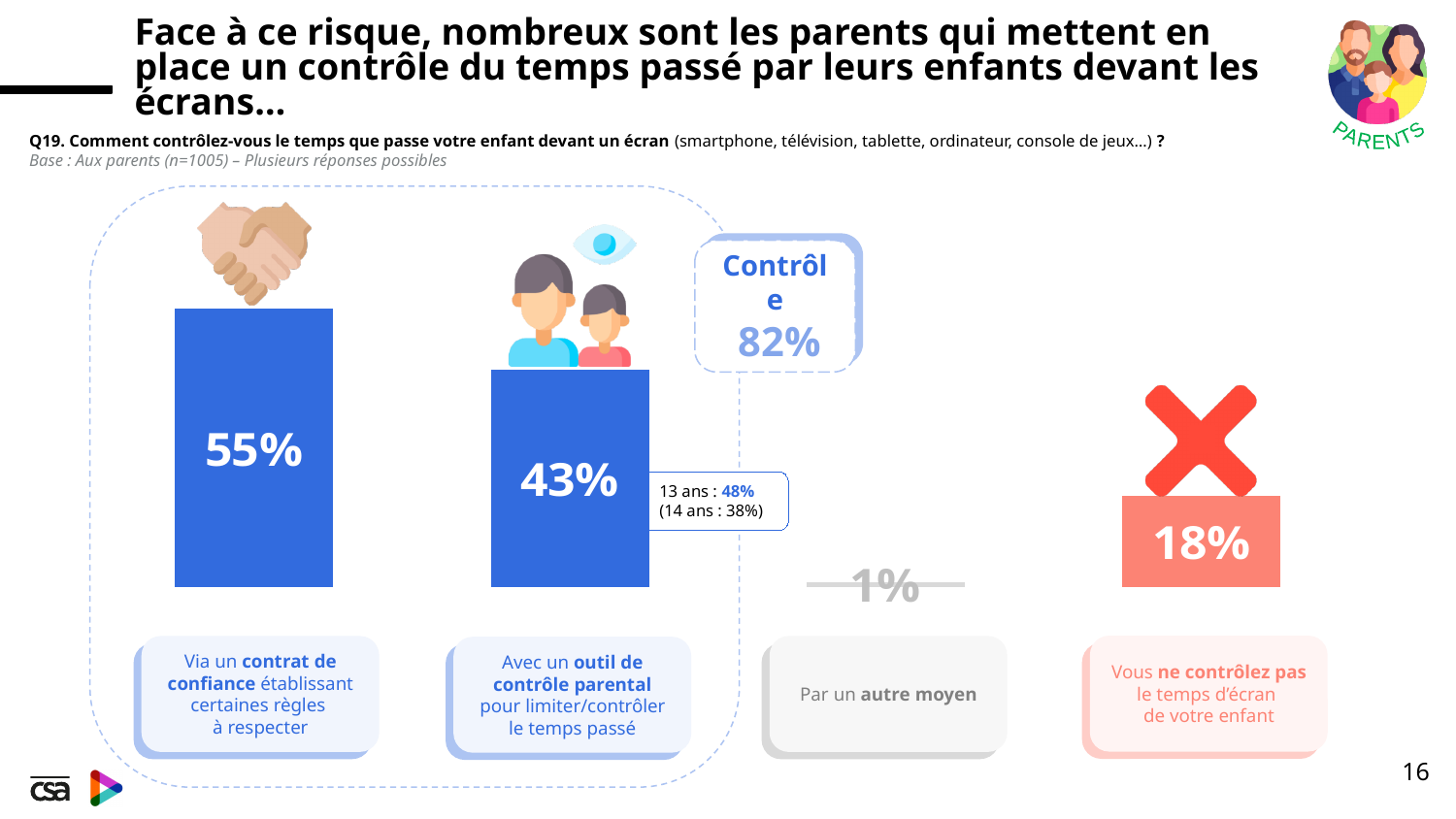
What percentage of parents control screen time 'par un autre moyen'? 1% Which is larger: the share using an 'outil de contrôle parental' or the share who do not control screen time? Outil de contrôle parental What percentage of parents control screen time via a 'contrat de confiance'? 55% Among parents of 13-year-olds, what percentage use a parental control tool? 48% Which method of controlling screen time has the highest percentage? Via un contrat de confiance Which category has the lowest percentage? Par un autre moyen What percentage of parents say they do not control their child's screen time ('ne contrôlez pas')? 18% How many response categories are shown in the chart? 4 What is the difference in percentage points between 'contrat de confiance' and 'outil de contrôle parental'? 12 What is the overall share of parents who exercise some form of control ('Contrôle'), as shown in the callout? 82% What percentage of parents use an 'outil de contrôle parental' to limit screen time? 43% Among parents of 14-year-olds, what percentage use a parental control tool? 38%